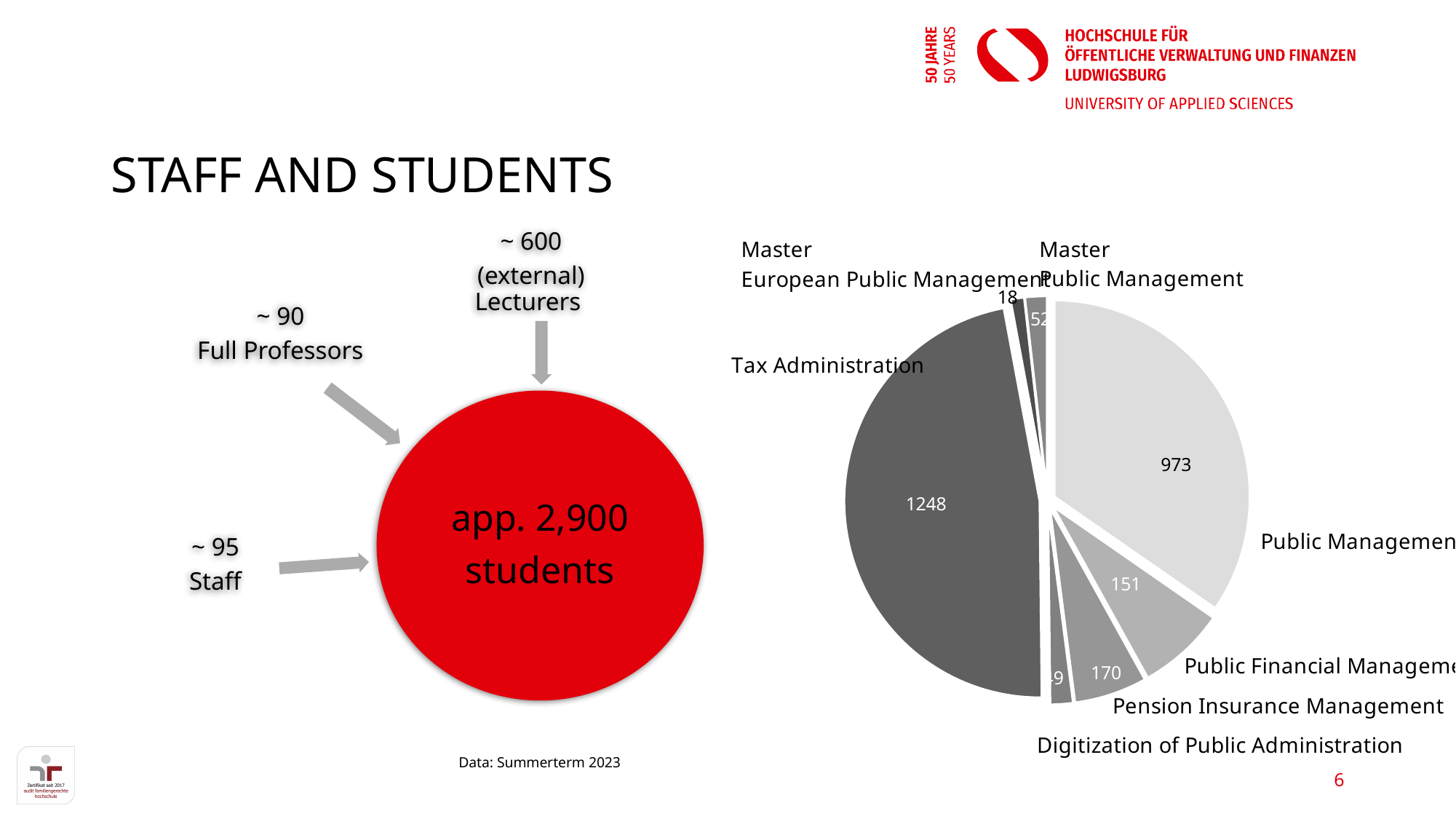
Which slice of the pie chart is the smallest? Master European Public Management Which slice of the pie chart is the largest? Tax Administration In the pie chart, what is the value for Master European Public Management? 18 In the pie chart, what is the value for Public Financial Management? 151 How many slices does the pie chart have? 7 In the pie chart, what is the value for Pension Insurance Management? 170 In the pie chart, what is the value for Public Management? 973 In the pie chart, how many students are in Tax Administration? 1248 In the pie chart, what is the difference between Tax Administration and Public Management? 275 What type of chart is shown on the right side of the slide? pie chart In the pie chart, what is the value for Master Public Management? 52 In the pie chart, which is larger: Pension Insurance Management or Public Financial Management? Pension Insurance Management